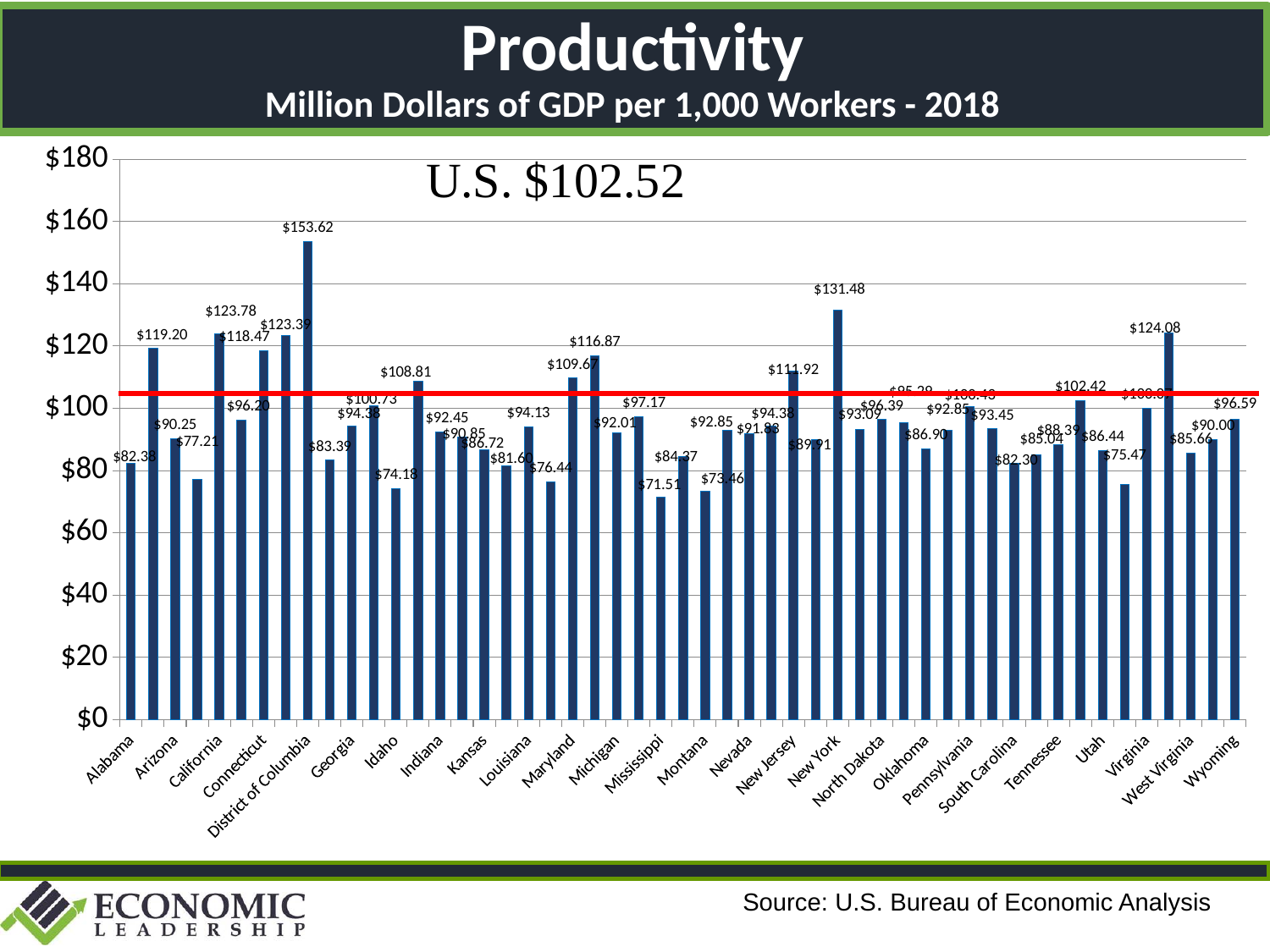
What is the value for the District of Columbia? $153.62 What kind of chart is shown on the slide? Bar chart What is the value for California? $123.78 What is the difference between the values for New York and New Jersey? $19.56 Is the value for Idaho greater or less than $80? less Is the value for Wyoming greater or less than $100? less Which category has the lowest value? Mississippi Which category has the highest value? District of Columbia Which is larger, the value for Connecticut or the value for Maryland? Connecticut What is the value for New York? $131.48 What U.S. value is printed on the chart? $102.52 What is the value for Mississippi? $71.51